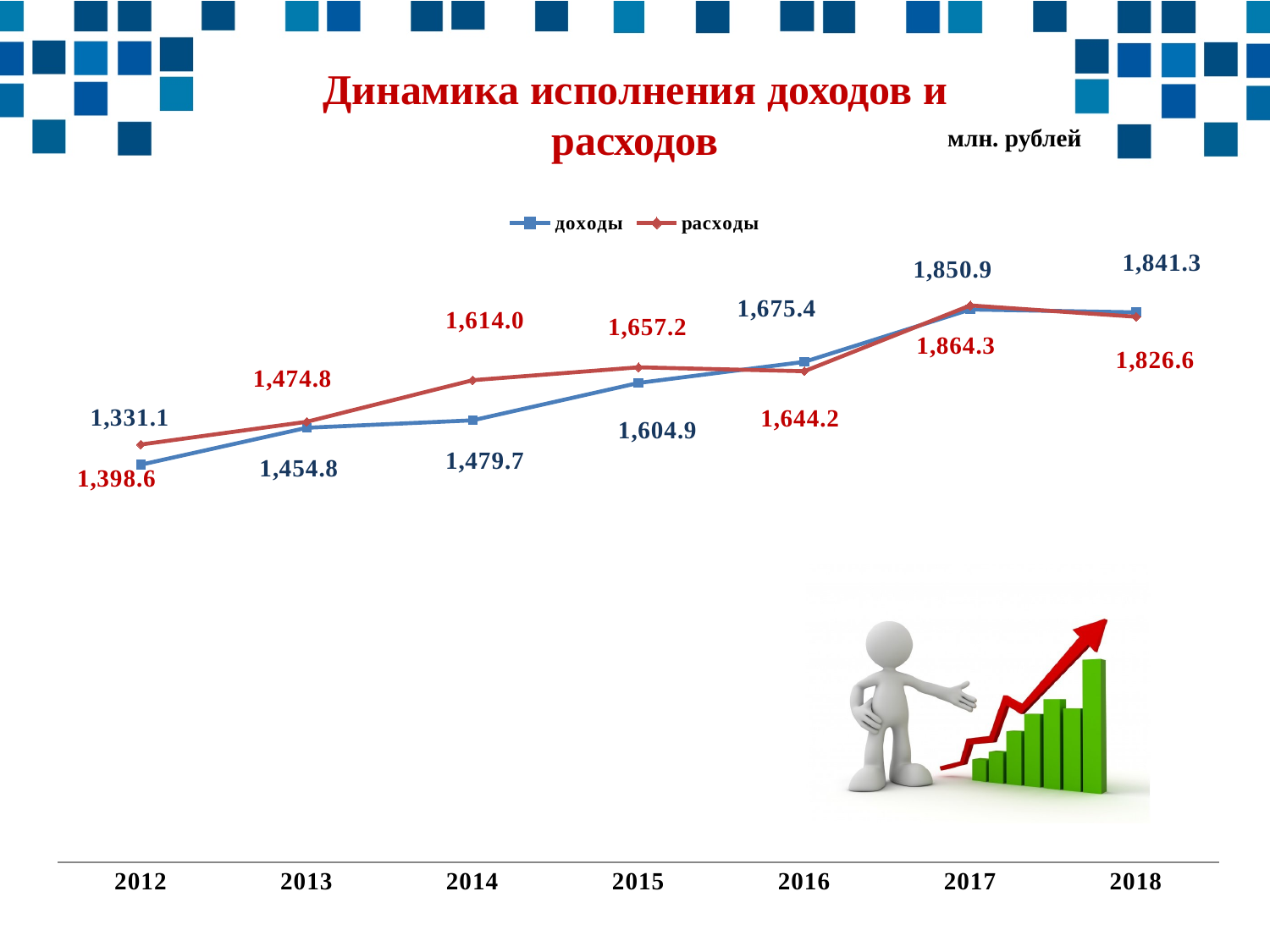
Which is larger in 2016, доходы or расходы? доходы What is the difference between расходы and доходы in 2012? 67.5 What is the value of расходы in 2014? 1,614.0 What is the value of доходы in 2015? 1,604.9 How many years are shown on the x axis? 7 What is the value of расходы in 2018? 1,826.6 Does доходы rise or fall from 2012 to 2017? rise How many series does the legend list? 2 In which year is доходы highest? 2017 What kind of chart is shown on the slide? line chart In which year is расходы lowest? 2012 What is the difference between расходы and доходы in 2017? 13.4